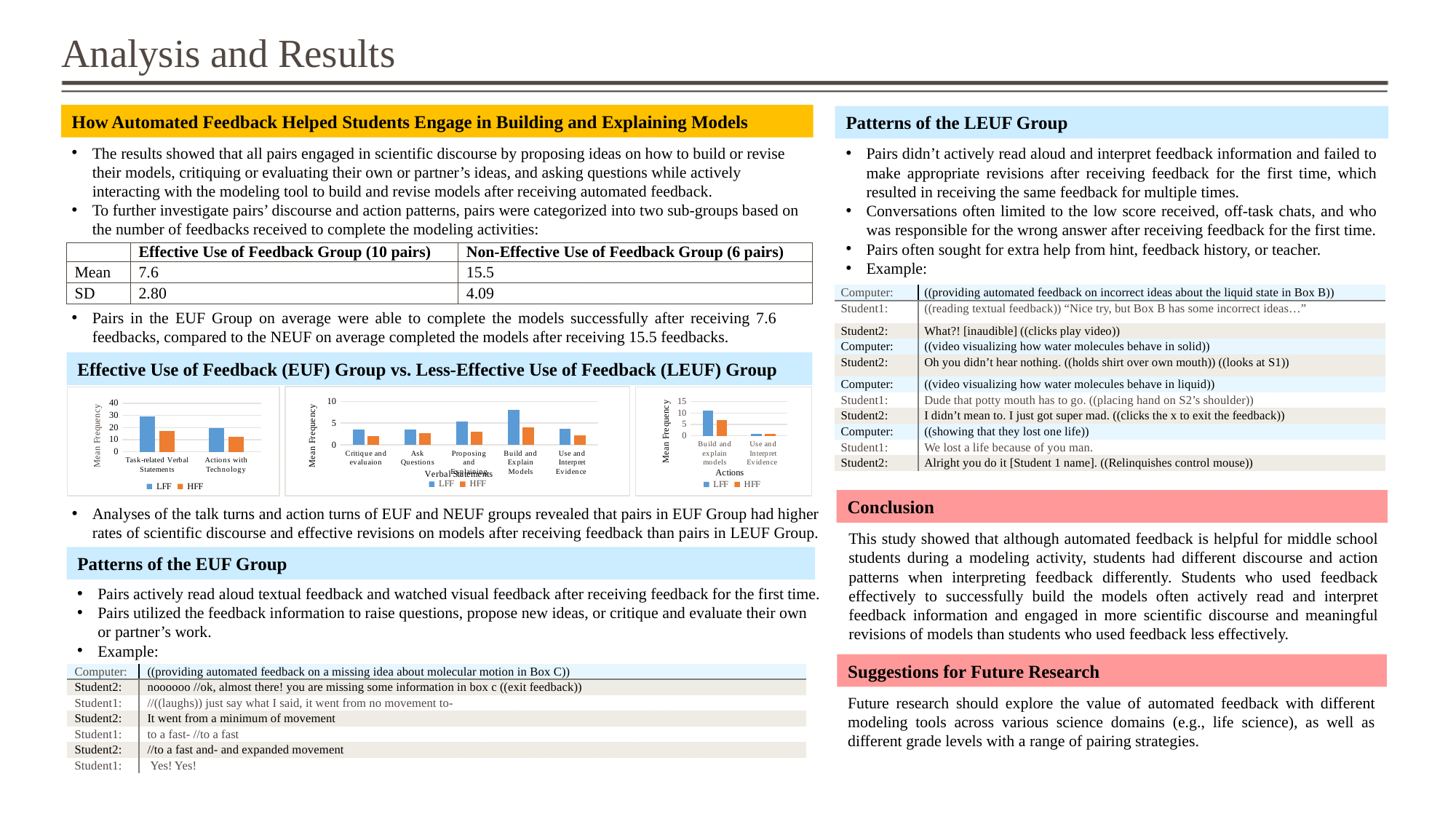
In the right chart (Actions), is the LFF value for Build and explain models greater or less than 10? greater In the right chart (Actions), which category has the lowest LFF value? Use and Interpret Evidence In the middle chart (Verbal Statements), which is larger for Proposing and Explaining: the LFF value or the HFF value? LFF How many categories are shown on the x axis of the right chart (Actions)? 2 In the left chart, is the LFF value for Task-related Verbal Statements greater or less than 20? greater How many series does the legend of the middle chart (Verbal Statements) list? 2 In the middle chart (Verbal Statements), is the LFF value for Build and Explain Models greater or less than 5? greater How many categories are shown on the x axis of the middle chart (Verbal Statements)? 5 In the middle chart (Verbal Statements), which category has the highest LFF value? Build and Explain Models What is the y-axis title of the left chart? Mean Frequency What kind of chart is the left chart (with categories Task-related Verbal Statements and Actions with Technology)? bar chart